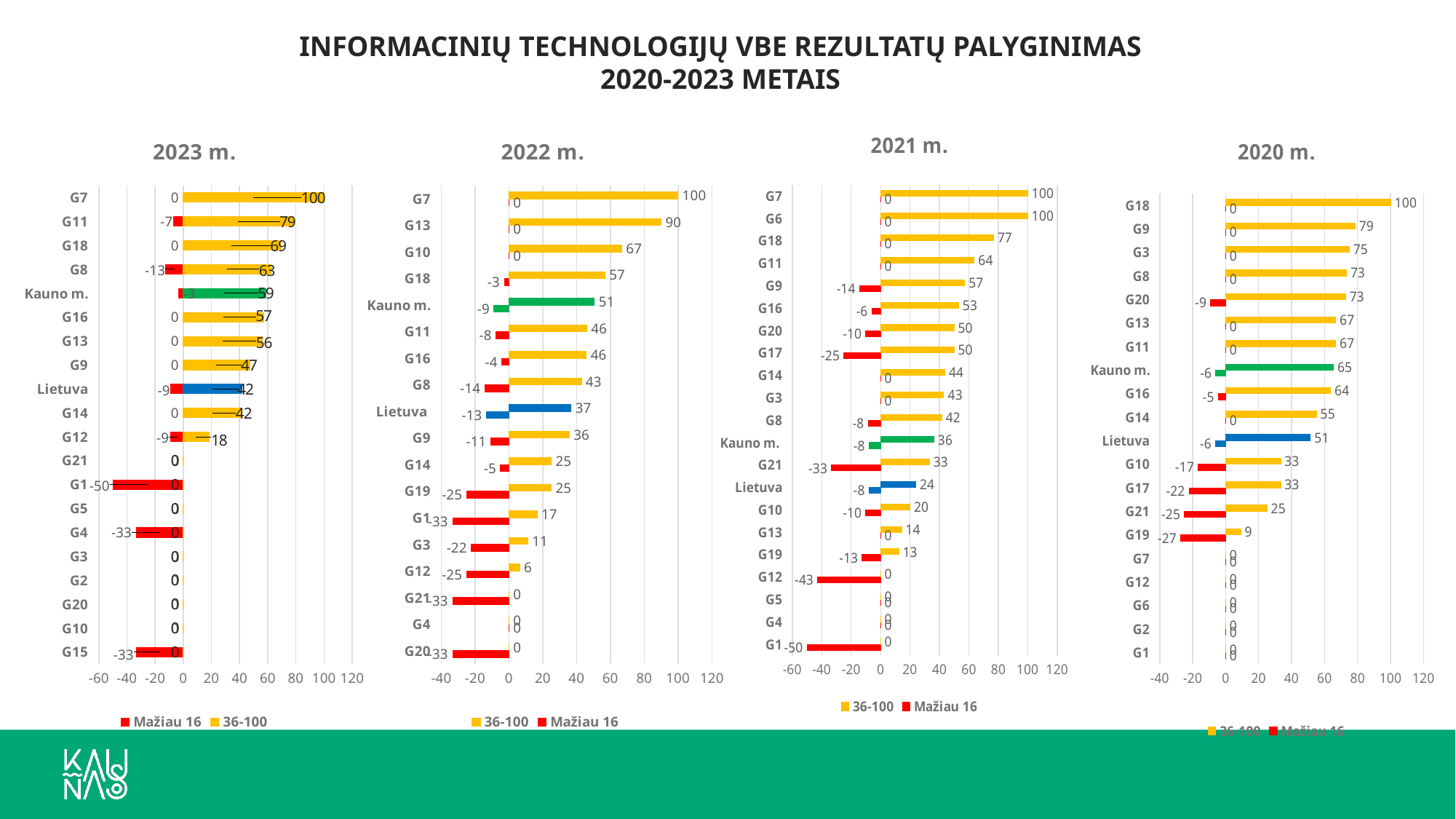
In the 2021 m. chart, which category has the lowest Mažiau 16 value? G1 In the 2023 m. chart, what is the Mažiau 16 value for G1? -50 What kind of chart is the 2021 m. chart? Bar chart In the 2021 m. chart, what is the 36-100 value for Kauno m.? 36 In the 2022 m. chart, what is the Mažiau 16 value for Lietuva? -13 In the 2022 m. chart, what is the 36-100 value for G13? 90 In the 2020 m. chart, what is the difference between the 36-100 values for G9 and Lietuva? 28 In the 2022 m. chart, which has the larger 36-100 value, G10 or G18? G10 How many series does the legend of the 2023 m. chart list? 2 In the 2020 m. chart, which category has the highest 36-100 value? G18 In the 2023 m. chart, what is the 36-100 value for G11? 79 How many charts are shown on the slide? 4